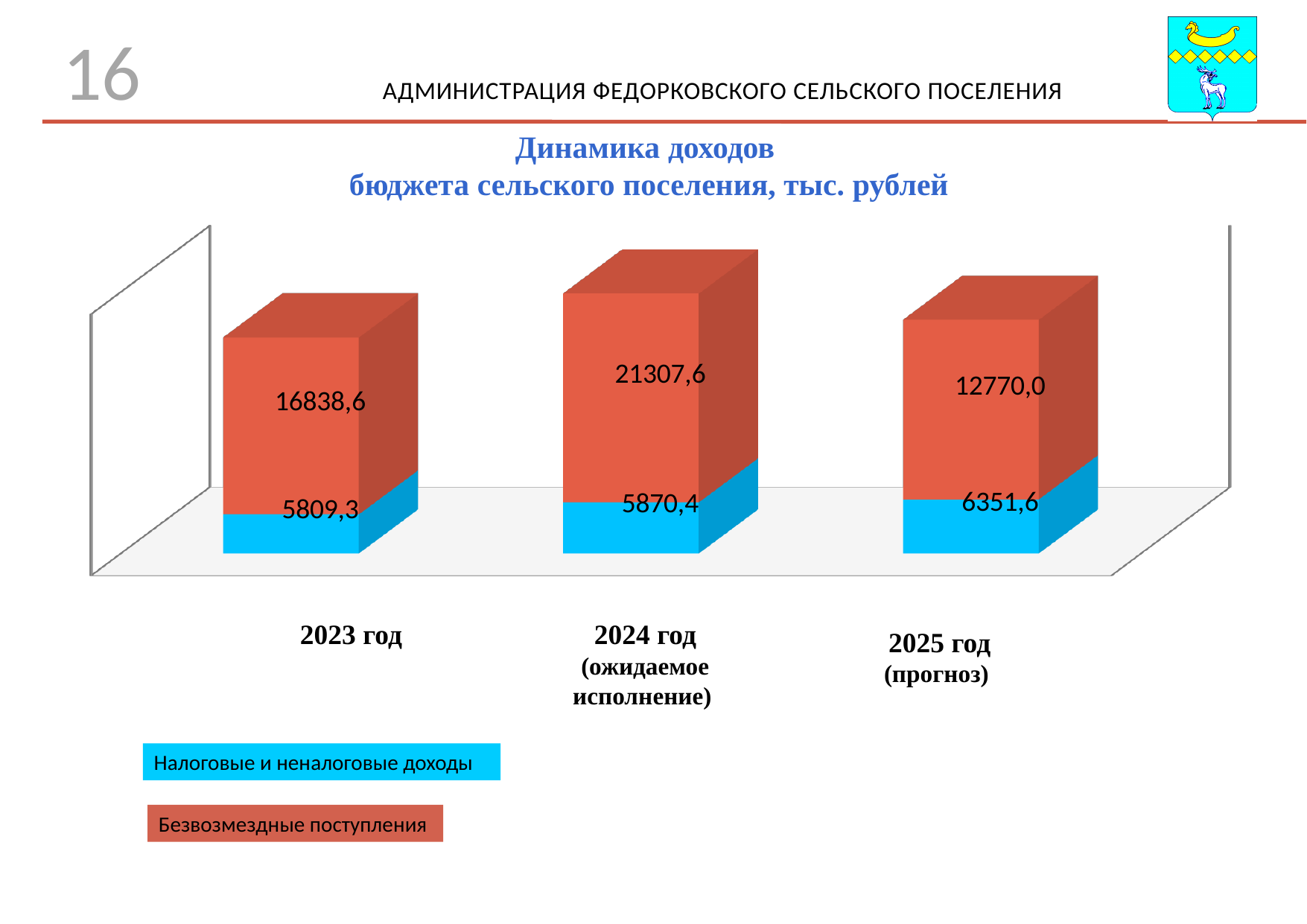
In which year is Налоговые и неналоговые доходы the lowest? 2023 год In which year is Безвозмездные поступления the highest? 2024 год (ожидаемое исполнение) How many series does the legend list? 2 How many years (categories) are shown on the chart? 3 What is the total of the stacked bar for 2024 год (ожидаемое исполнение)? 27178,0 What is the value of Налоговые и неналоговые доходы for 2024 год (ожидаемое исполнение)? 5870,4 What is the difference between Безвозмездные поступления in 2024 год and in 2023 год? 4469,0 Which is larger: Безвозмездные поступления in 2023 год or in 2025 год? 2023 год What is the value of Безвозмездные поступления for 2023 год? 16838,6 What is the value of Налоговые и неналоговые доходы for 2025 год (прогноз)? 6351,6 What is the total of the stacked bar for 2025 год (прогноз)? 19121,6 What is the difference between Налоговые и неналоговые доходы in 2025 год and in 2023 год? 542,3